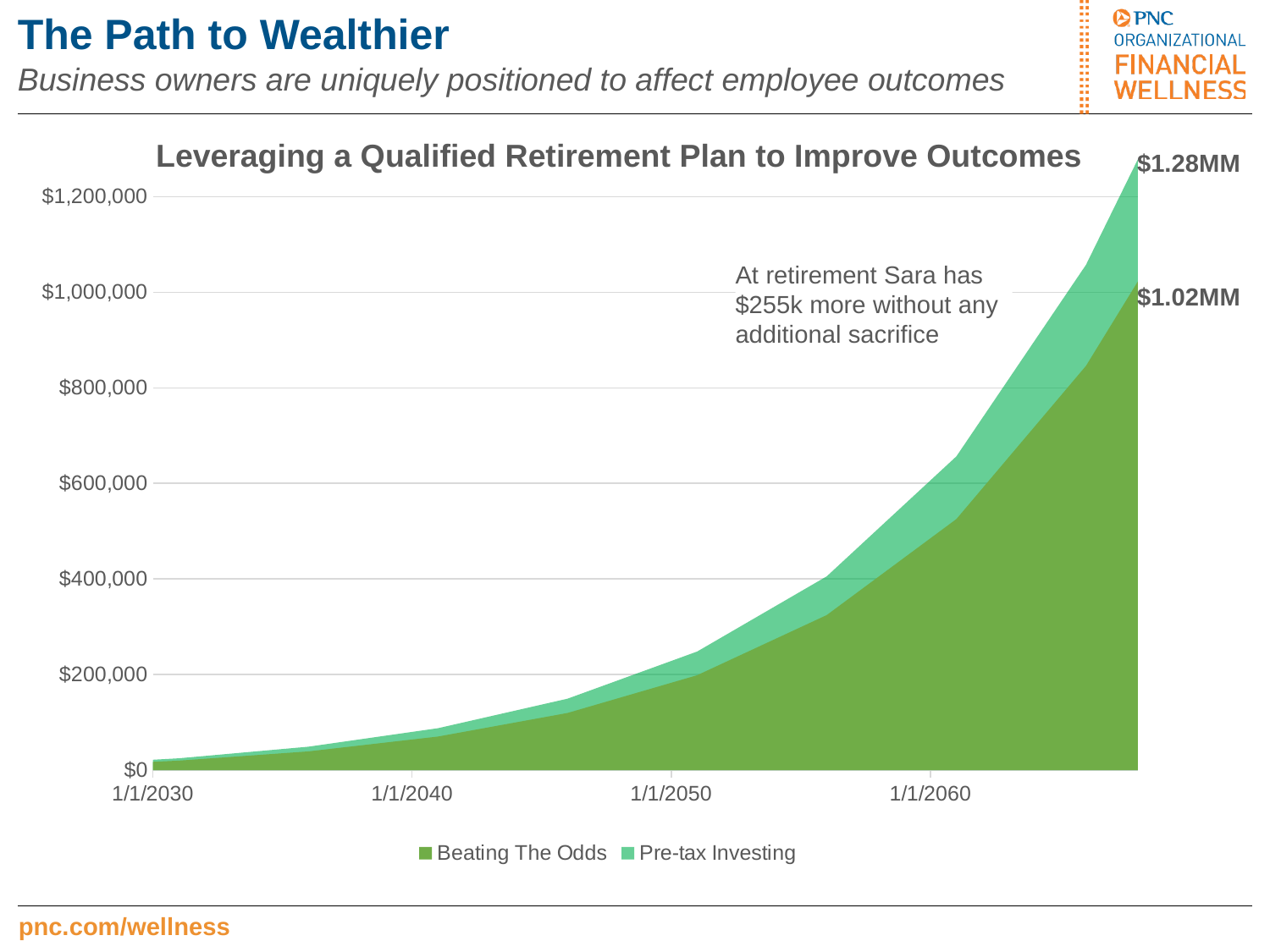
What is the first date label on the x axis? 1/1/2030 Is the value for Beating The Odds at 1/1/2050 greater or less than $400,000? less What is the labeled end value of the Pre-tax Investing series? $1.28MM Do the values rise or fall from 1/1/2030 to the end of the chart? rise What is the title of the chart? Leveraging a Qualified Retirement Plan to Improve Outcomes According to the annotation, how much more does Sara have at retirement without any additional sacrifice? $255k Which series ends at a higher value, Beating The Odds or Pre-tax Investing? Pre-tax Investing What kind of chart is shown on the slide? area chart Is the value for Beating The Odds at 1/1/2060 greater or less than $400,000? greater What is the labeled end value of the Beating The Odds series? $1.02MM How many date labels are shown on the x axis? 4 How many series does the legend list? 2